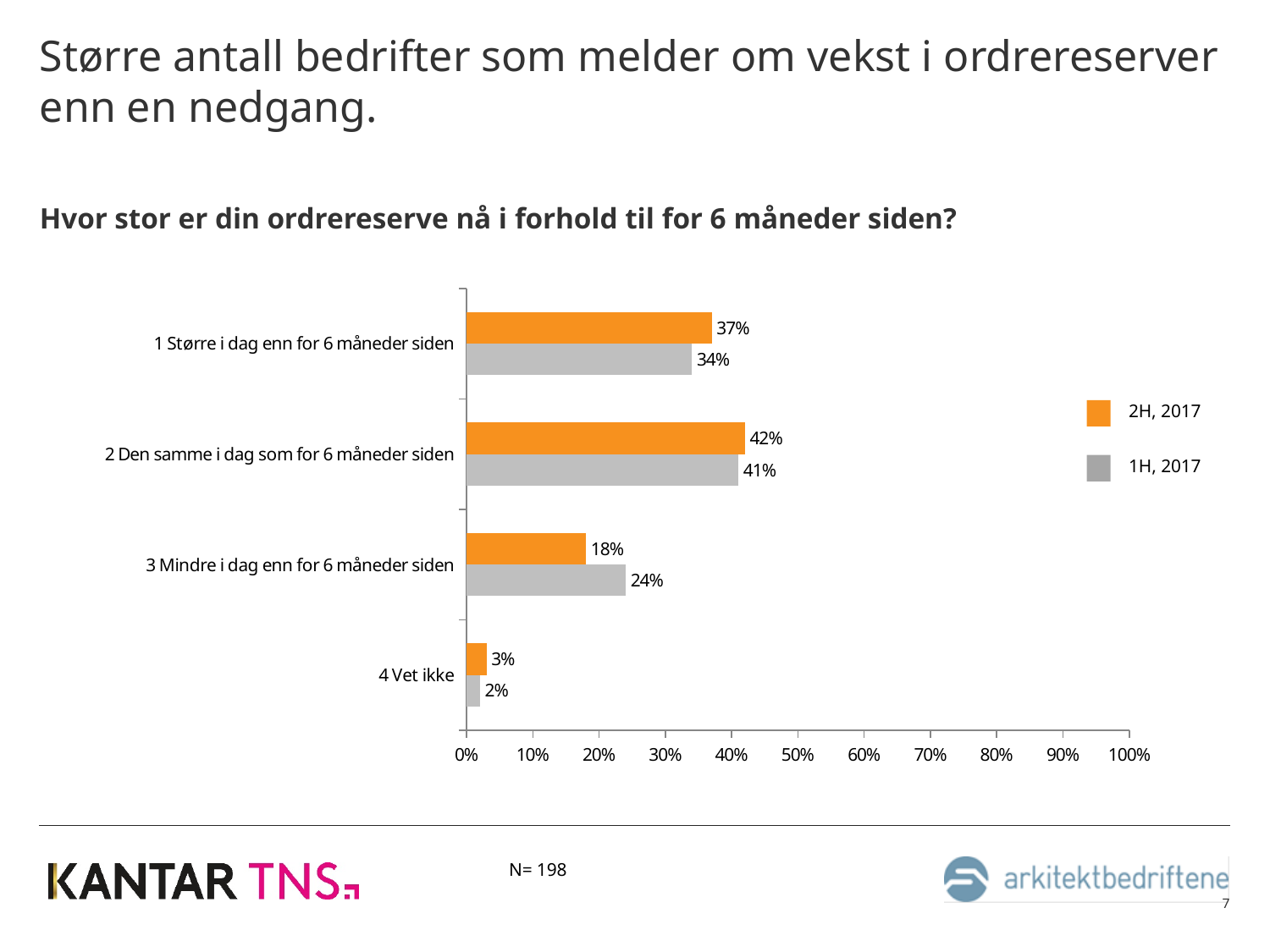
What kind of chart is shown on the slide? Bar chart What colour represents the 1H, 2017 series? Grey Which category has the highest value in the 2H, 2017 series? 2 Den samme i dag som for 6 måneder siden What is the value for "3 Mindre i dag enn for 6 måneder siden" in the 1H, 2017 series? 24% How many categories are shown on the chart? 4 What is the difference between the 1H, 2017 and 2H, 2017 values for "3 Mindre i dag enn for 6 måneder siden"? 6% Is the 2H, 2017 value for "2 Den samme i dag som for 6 måneder siden" greater or less than 40%? greater How many series does the legend list? 2 For "1 Større i dag enn for 6 måneder siden", which series has the larger value, 2H, 2017 or 1H, 2017? 2H, 2017 What is the value for "1 Større i dag enn for 6 måneder siden" in the 2H, 2017 series? 37% What is the value for "4 Vet ikke" in the 2H, 2017 series? 3% Which category has the lowest value in the 1H, 2017 series? 4 Vet ikke